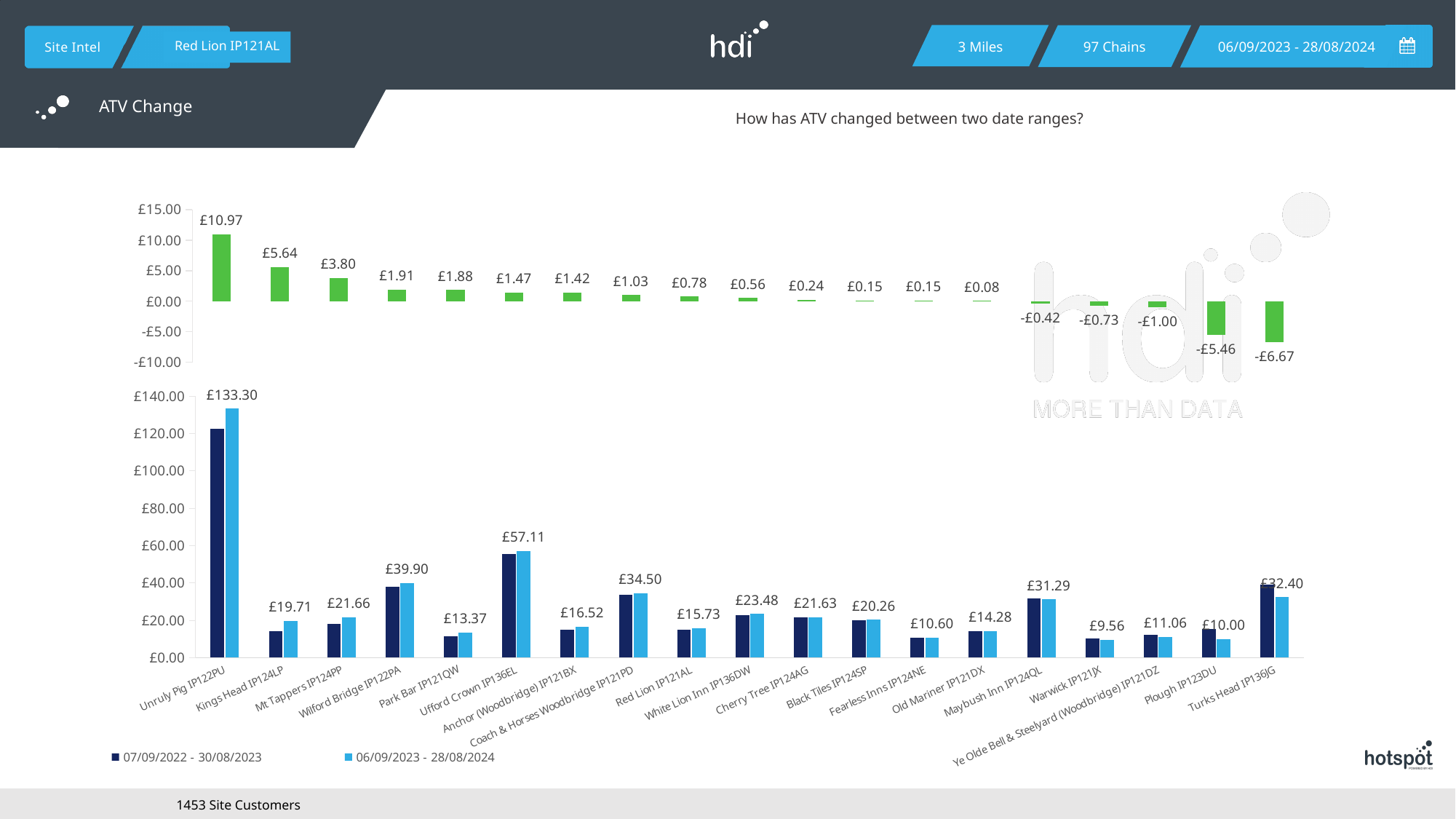
What is the highest value shown in the top chart? £10.97 In the bottom chart, what is the difference between Unruly Pig IP122PU and Ufford Crown IP136EL in the 06/09/2023 - 28/08/2024 series? £76.19 In the bottom chart, what is the value for Ufford Crown IP136EL in the 06/09/2023 - 28/08/2024 series? £57.11 How many categories are shown on the x axis of the bottom chart? 19 In the bottom chart, is the value for Ufford Crown IP136EL in the 07/09/2022 - 30/08/2023 series greater or less than £40.00? greater In the bottom chart, what is the value for Red Lion IP121AL in the 06/09/2023 - 28/08/2024 series? £15.73 In the bottom chart, which category has the lowest value in the 06/09/2023 - 28/08/2024 series? Warwick IP121JX In the bottom chart, what is the value for Unruly Pig IP122PU in the 06/09/2023 - 28/08/2024 series? £133.30 In the bottom chart, which category has the highest value in the 06/09/2023 - 28/08/2024 series? Unruly Pig IP122PU How many series does the legend of the bottom chart list? 2 What is the lowest value shown in the top chart? -£6.67 In the bottom chart, which is larger in the 06/09/2023 - 28/08/2024 series: Wilford Bridge IP122PA or Coach & Horses Woodbridge IP121PD? Wilford Bridge IP122PA